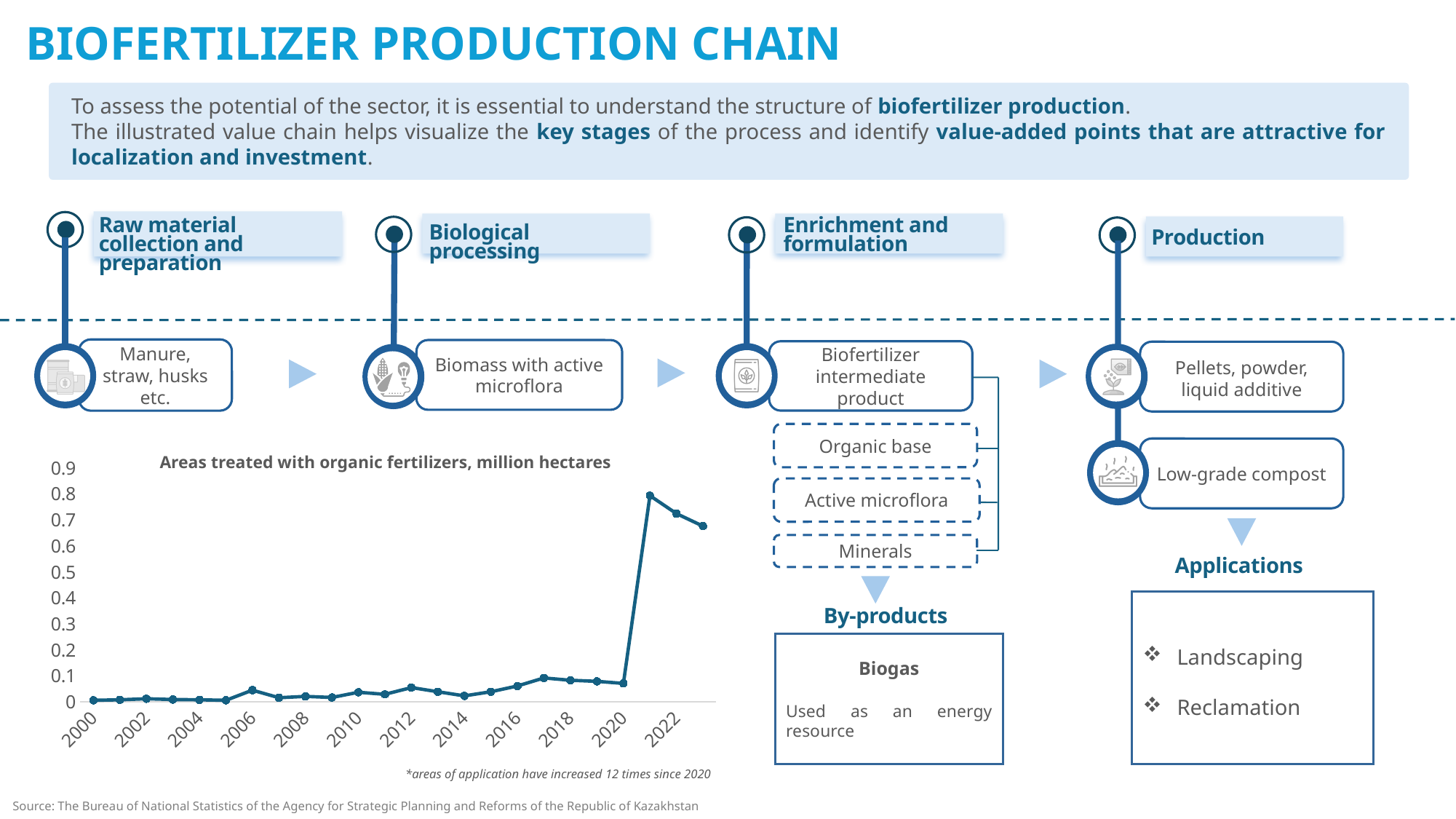
Which year has the larger value, 2020 or 2021? 2021 Which year has the larger value, 2022 or 2023? 2022 What is the title of the chart on the slide? Areas treated with organic fertilizers, million hectares According to the footnote under the chart, by how many times have areas of application increased since 2020? 12 times How many year labels are shown on the x axis of the chart? 12 Does the line rise or fall between 2021 and 2023? Falls What kind of chart is shown on the slide? Line chart Is the value for 2021 greater or less than 0.7? greater In which year does the chart show the highest area treated with organic fertilizers? 2021 Is the value for 2020 greater or less than 0.1? less Is the value for 2017 greater or less than 0.2? less